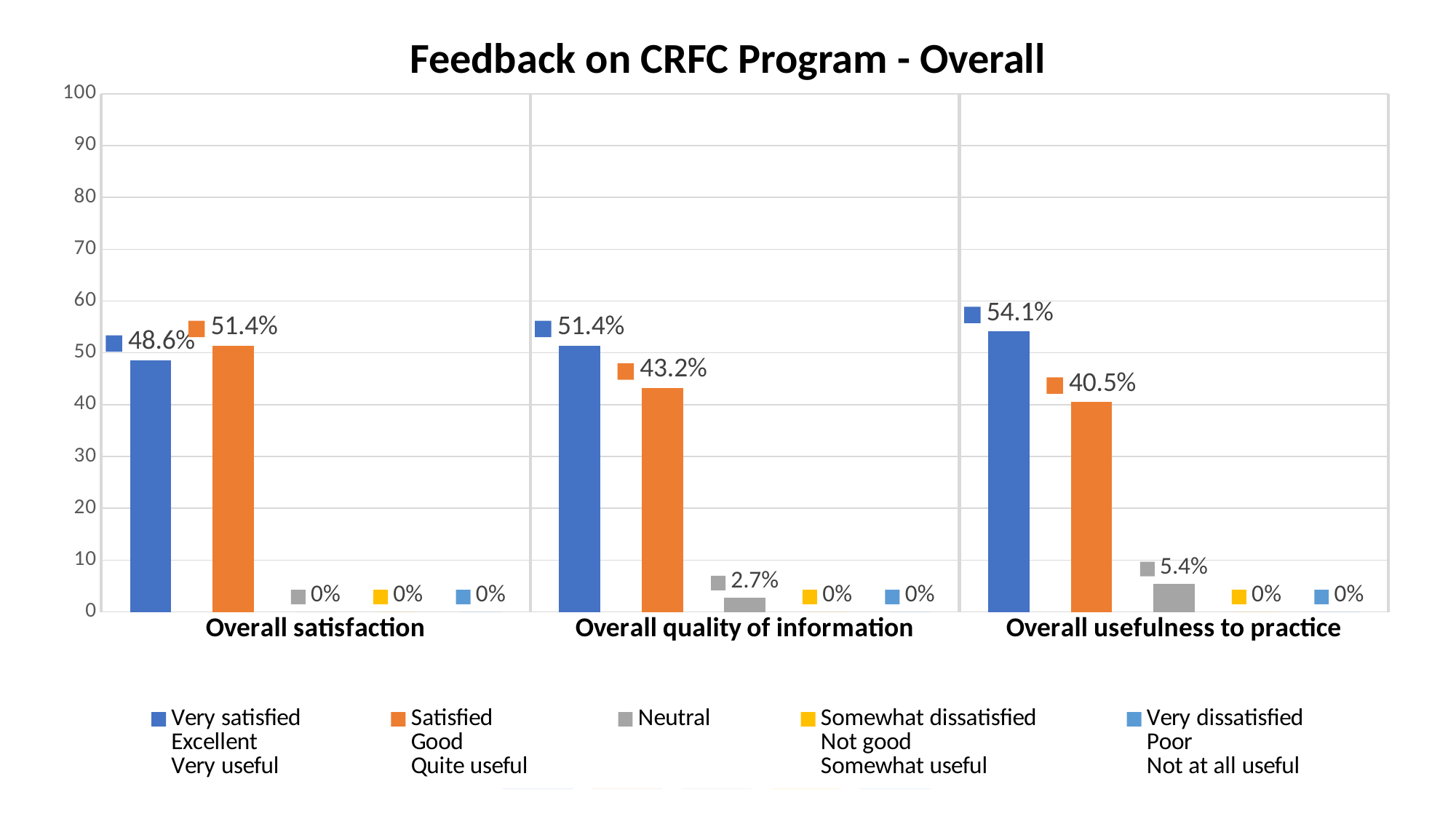
How many categories are shown on the x axis? 3 What is the difference between the Very satisfied and Satisfied values under Overall usefulness to practice? 13.6% What kind of chart is shown on the slide? Bar chart Which category has the highest Very satisfied value? Overall usefulness to practice What is the value for Very satisfied under Overall satisfaction? 48.6% How many series does the legend list? 5 What is the title of the chart? Feedback on CRFC Program - Overall What is the value for Neutral under Overall usefulness to practice? 5.4% What is the value for Satisfied under Overall quality of information? 43.2% What is the value for Neutral under Overall quality of information? 2.7% Under Overall satisfaction, which is larger: Very satisfied or Satisfied? Satisfied Which category has the lowest Satisfied value? Overall usefulness to practice